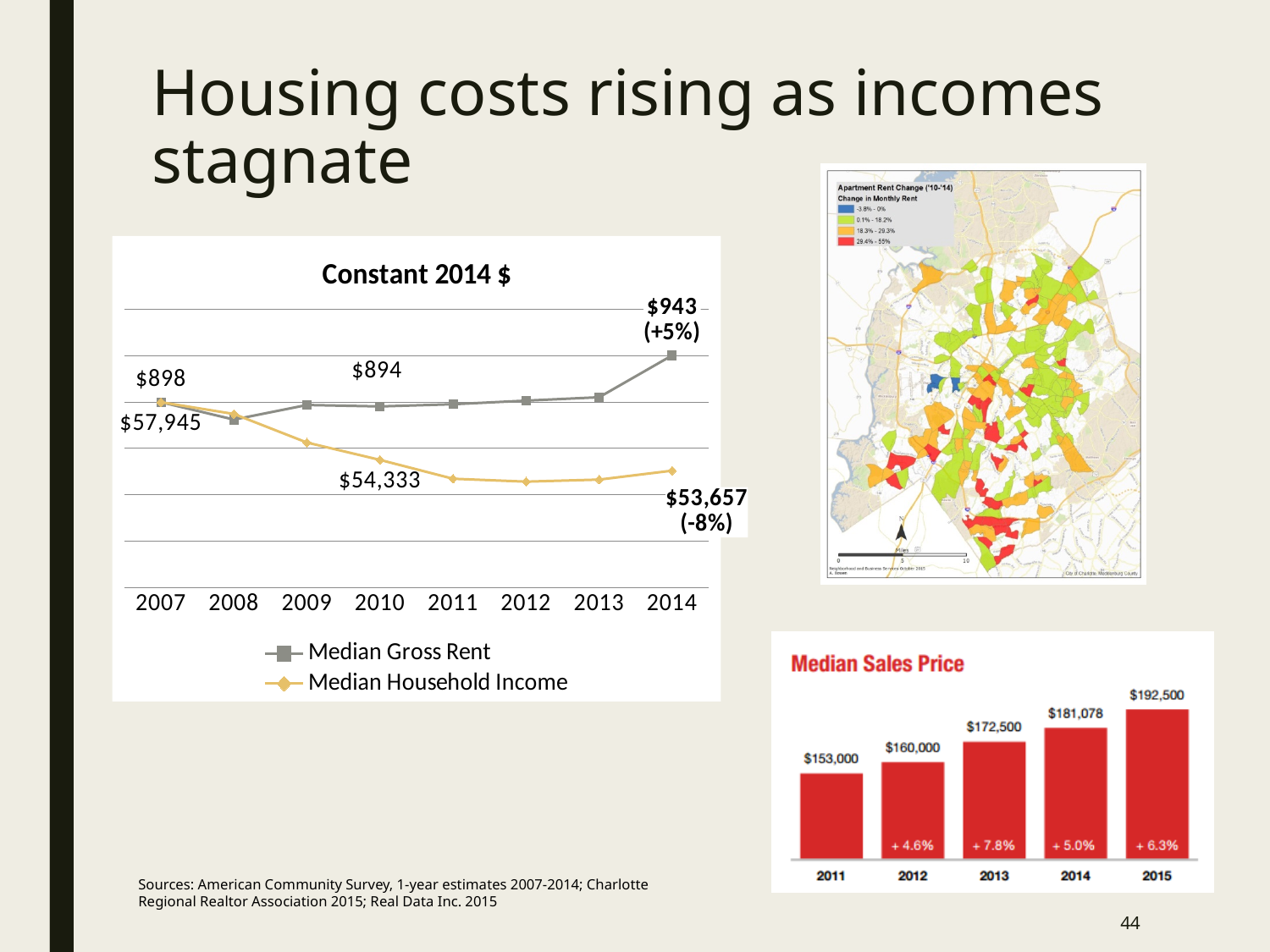
In the 'Constant 2014 $' chart, how many series does the legend list? 2 In the 'Constant 2014 $' chart, how many years are shown on the x axis? 8 In the 'Constant 2014 $' chart, what is the Median Household Income in 2007? $57,945 In the 'Constant 2014 $' chart, what percentage change in Median Household Income is labelled for 2014? -8% In the 'Constant 2014 $' chart, does Median Household Income rise or fall from 2007 to 2014? fall In the 'Median Sales Price' chart, what is the value for 2014? $181,078 In the 'Median Sales Price' chart, which year has the highest median sales price? 2015 In the 'Constant 2014 $' chart, what is the difference between Median Gross Rent in 2014 and in 2007? $45 In the 'Constant 2014 $' chart, what is the Median Household Income in 2014? $53,657 What kind of chart is the 'Median Sales Price' chart? bar chart In the 'Median Sales Price' chart, what is the difference between the 2015 and 2011 values? $39,500 In the 'Constant 2014 $' chart, what is the Median Gross Rent in 2014? $943